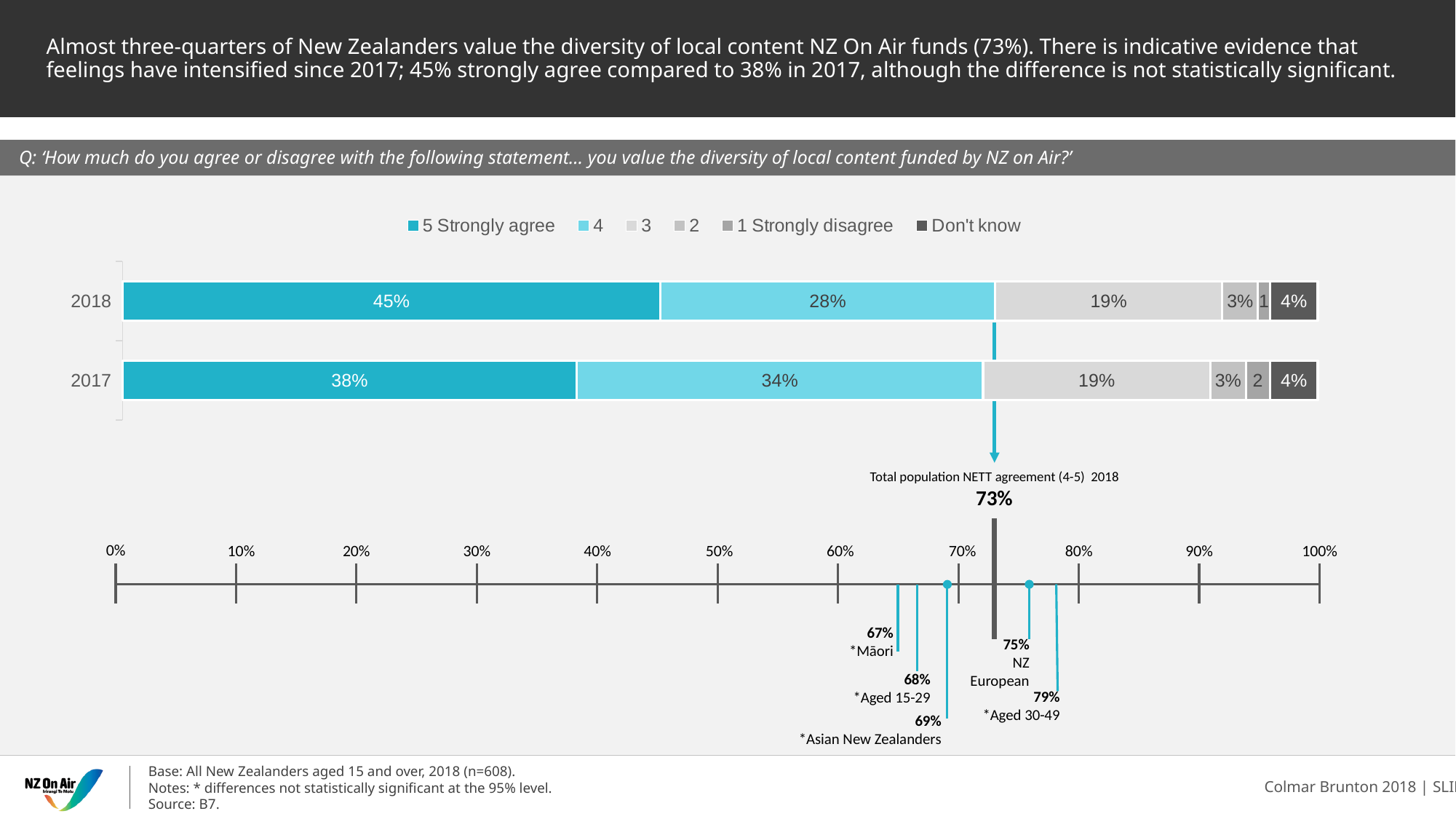
On the number line below the bars, what is the total population NETT agreement (4-5) for 2018? 73% In the stacked bar chart, what is the 'Don't know' percentage for 2018? 4% In the stacked bar chart, by how many percentage points did the '5 Strongly agree' share increase from 2017 to 2018? 7 percentage points In the stacked bar chart, what percentage of respondents in 2017 chose '4'? 34% How many series does the legend of the stacked bar chart list? 6 What kind of chart is used to show the 2018 and 2017 agreement results? Stacked bar chart In the stacked bar chart, what percentage of respondents in 2017 chose '3'? 19% On the number line below the bars, which subgroup has the lowest NETT agreement? Māori (67%) In the stacked bar chart, which year has the larger share of respondents choosing '4', 2018 or 2017? 2017 On the number line below the bars, what is the NETT agreement for those aged 30-49? 79% In the stacked bar chart, what percentage of respondents in 2018 chose '5 Strongly agree'? 45% How many years (bars) are shown in the stacked bar chart? 2